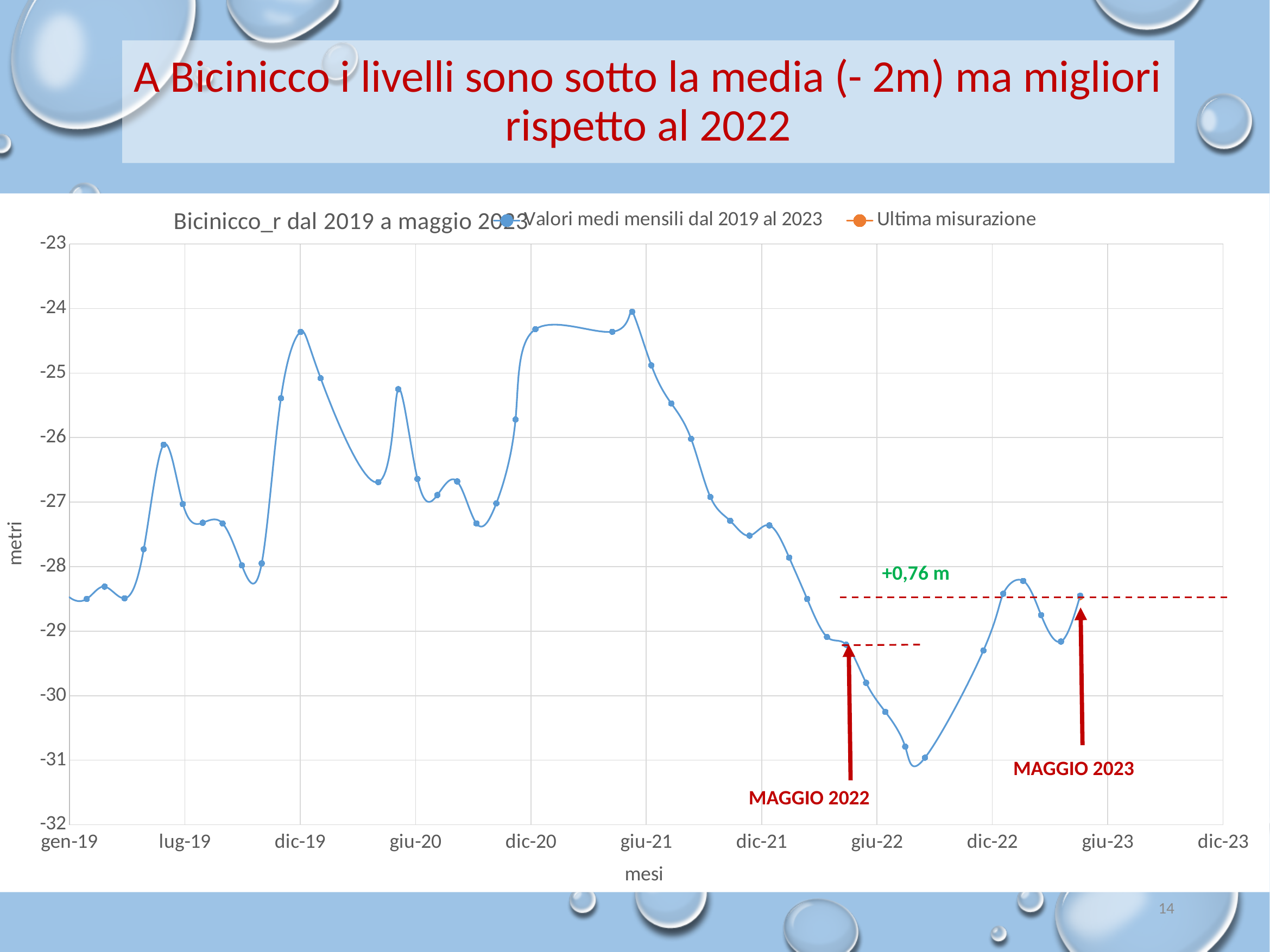
Do the values rise or fall between giu-21 and giu-22? fall Is the value for dic-19 greater or less than -25? less Which is larger, the value at dic-19 or the value at dic-21? dic-19 Is the value for giu-22 greater or less than -29? less How many series does the chart legend list? 2 What is the label of the vertical axis of the chart? metri Is the value for giu-21 greater or less than -25? greater What kind of chart is shown on the slide? line chart What is the title of the chart? Bicinicco_r dal 2019 a maggio 2023